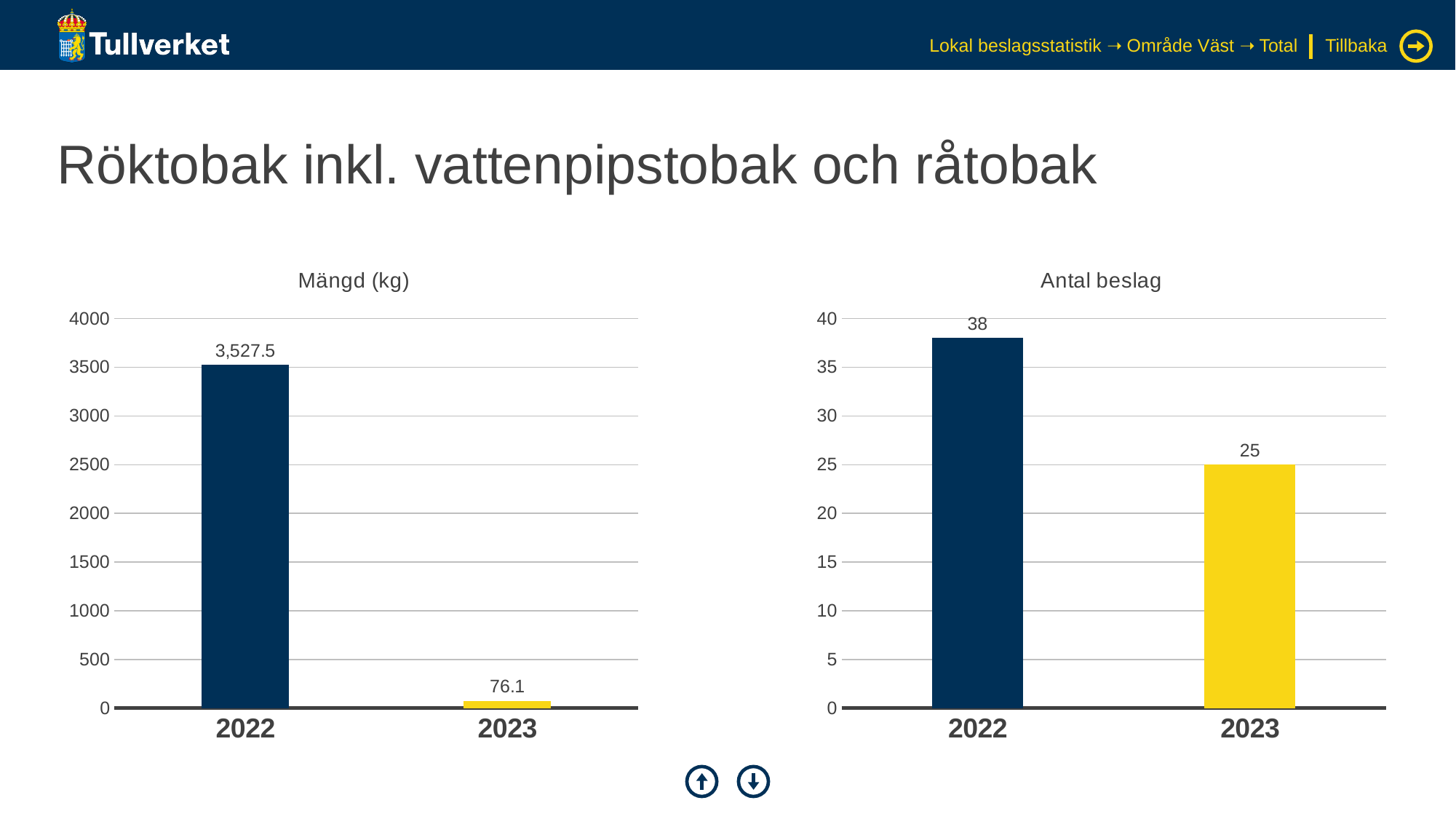
What kind of chart is the 'Mängd (kg)' chart? bar chart How many categories are shown on the x axis of the 'Antal beslag' chart? 2 In the 'Antal beslag' chart, which year has the highest value? 2022 In the 'Mängd (kg)' chart, is the value for 2022 greater or less than 3000? greater In the 'Antal beslag' chart, is the value for 2023 greater or less than 30? less In the 'Mängd (kg)' chart, what is the value for 2023? 76.1 In the 'Antal beslag' chart, what is the value for 2022? 38 In the 'Mängd (kg)' chart, what is the difference between the 2022 and 2023 values? 3,451.4 In the 'Mängd (kg)' chart, which year has the lowest value? 2023 In the 'Mängd (kg)' chart, what is the value for 2022? 3,527.5 In the 'Antal beslag' chart, what is the value for 2023? 25 In the 'Antal beslag' chart, what is the difference between the 2022 and 2023 values? 13